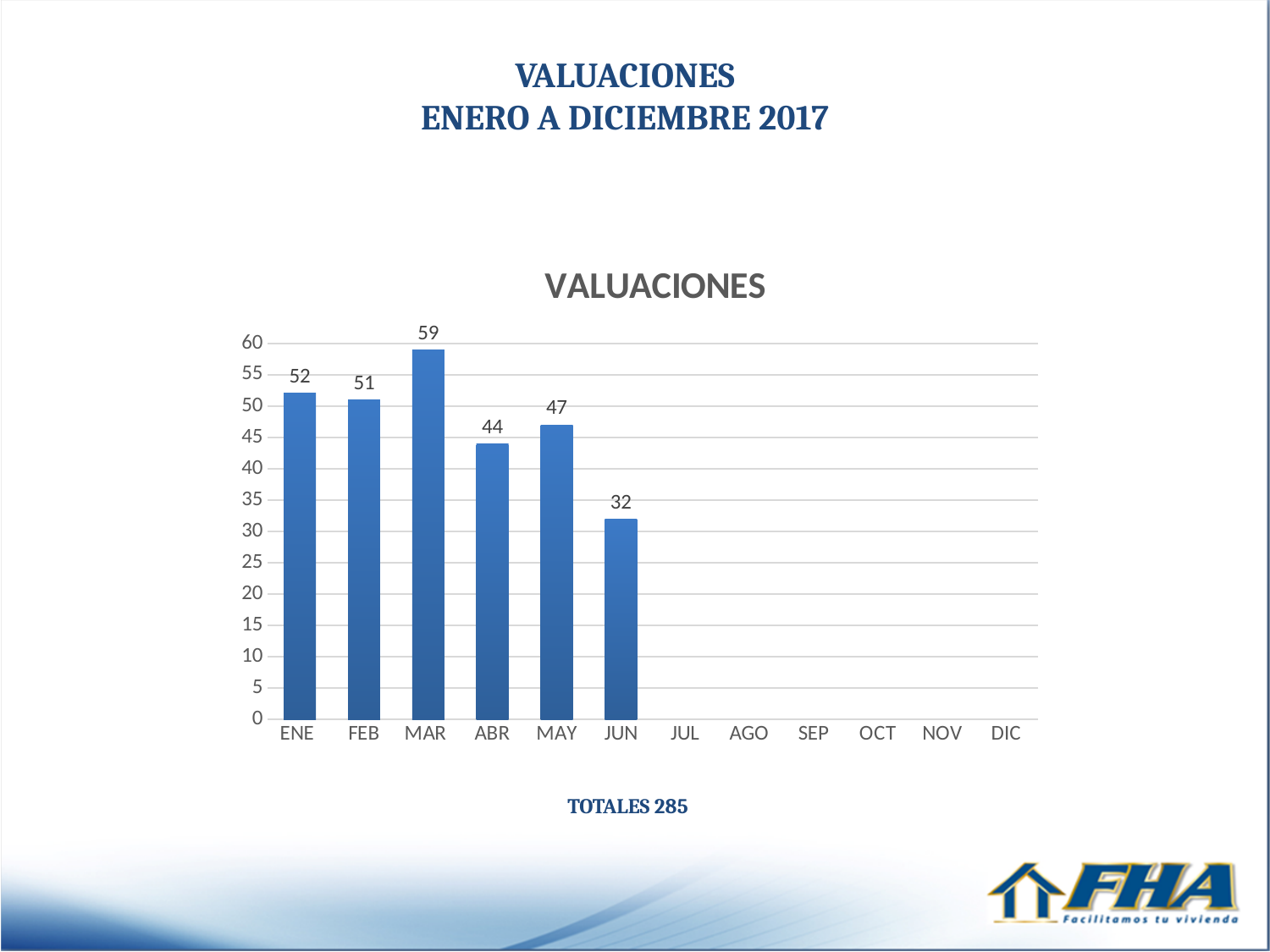
How many months have a bar plotted? 6 What is the value for ABR? 44 Among the months with bars, which has the lowest value? JUN What is the value for MAR? 59 Which month has the highest value? MAR Is the value for FEB greater or less than 40? greater How many month categories are shown on the x axis? 12 Which is larger, the value for ENE or the value for MAY? ENE What is the value for JUN? 32 What kind of chart is this? bar chart What is the difference between the values for MAR and JUN? 27 What is the title of the chart? VALUACIONES